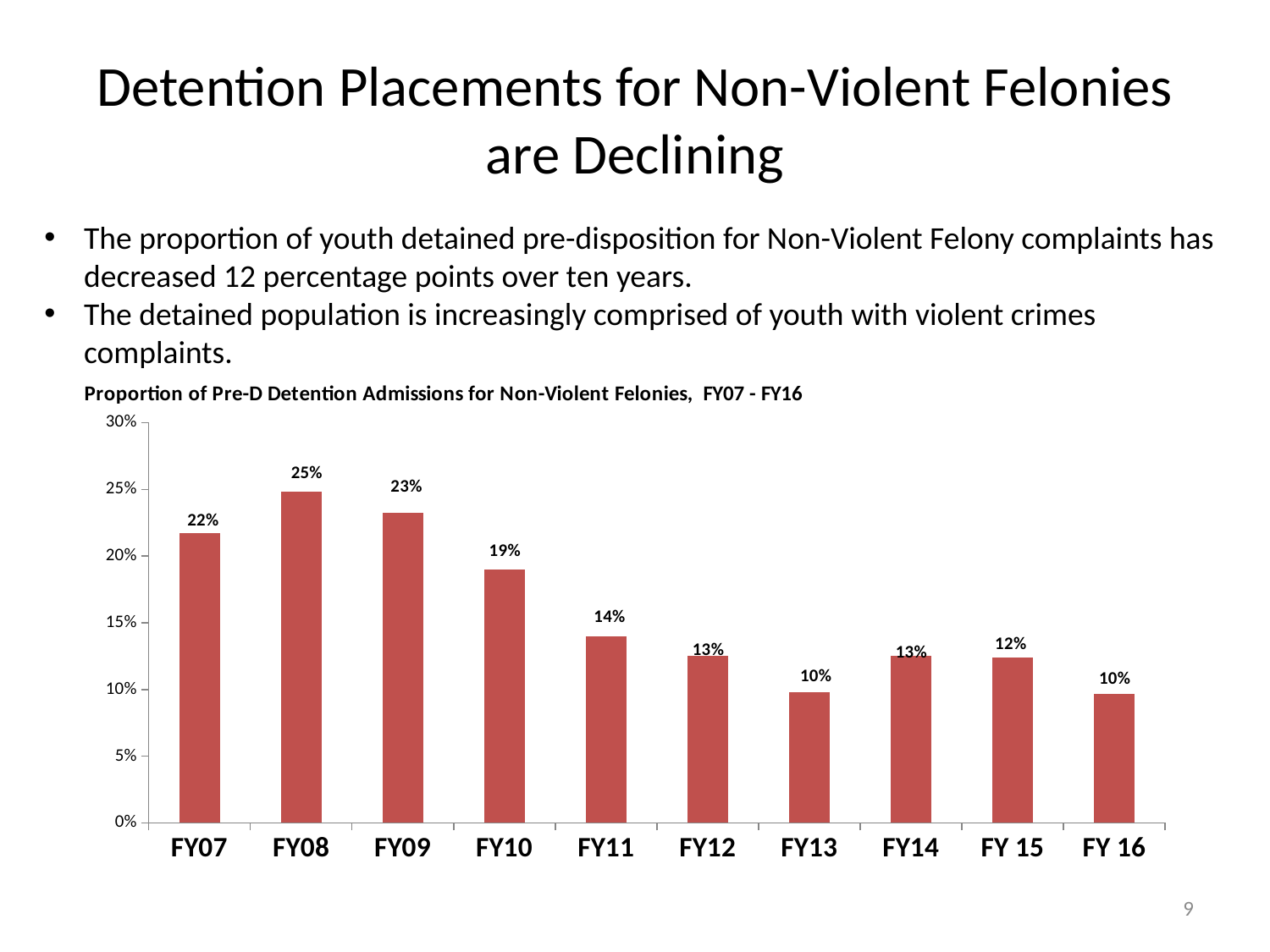
What is the value for FY11? 14% Do the values generally rise or fall from FY07 to FY 16? Fall How many fiscal years are shown on the x axis? 10 What is the value for FY 16? 10% Which fiscal year has the highest proportion? FY08 What is the title of the chart? Proportion of Pre-D Detention Admissions for Non-Violent Felonies, FY07 - FY16 What is the difference between the values for FY07 and FY 16? 12 percentage points What is the value for FY08? 25% What is the difference between the values for FY08 and FY10? 6 percentage points Is the value for FY13 greater or less than 15%? less What kind of chart is shown on the slide? Bar chart Which is larger, the value for FY09 or the value for FY10? FY09